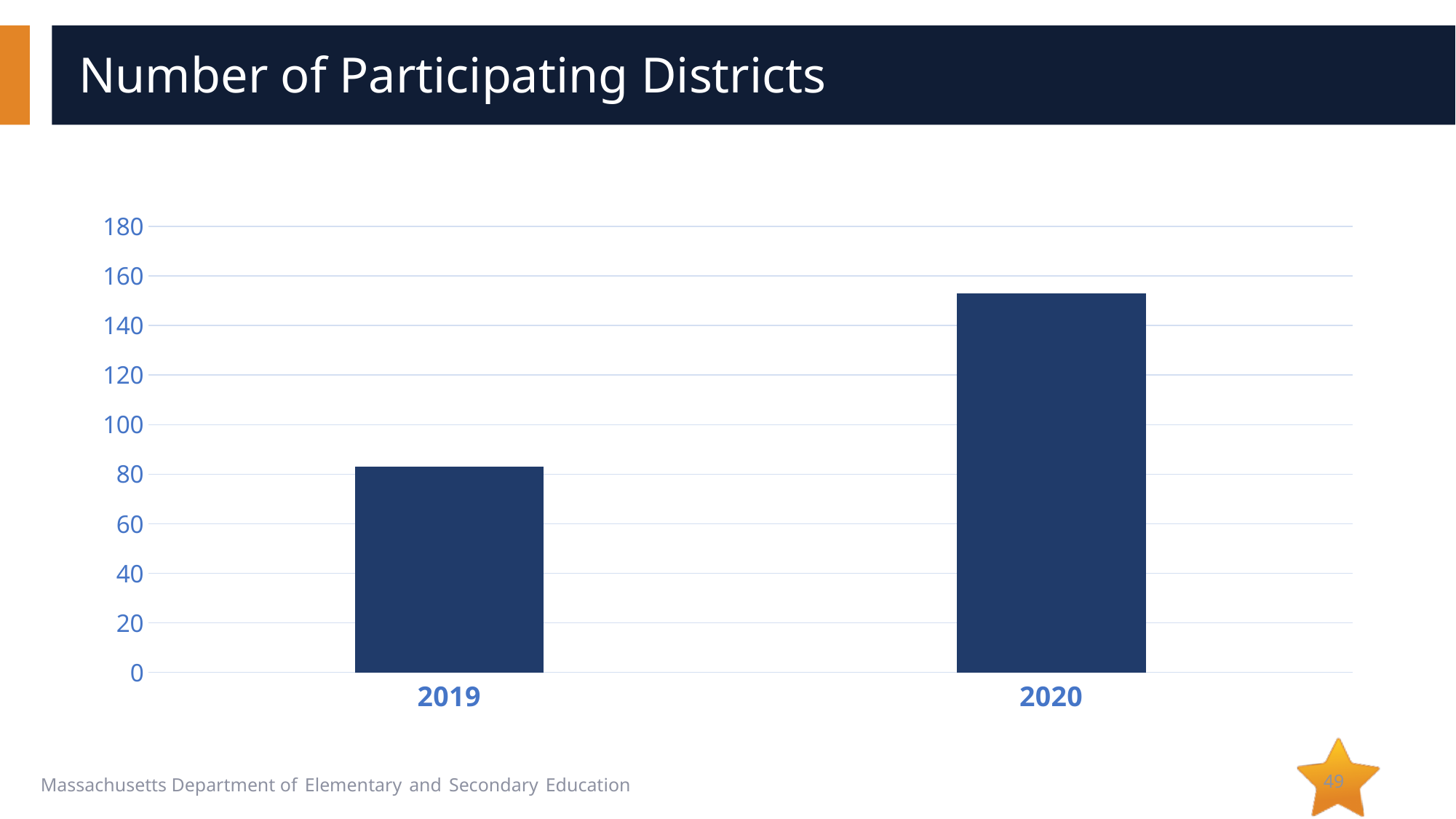
Is the value for 2019 greater or less than 100? less What kind of chart is shown on the slide? bar chart What is the title of the slide's chart? Number of Participating Districts Which year has the highest number of participating districts? 2020 Is the value for 2020 greater or less than 140? greater How many years are shown on the x axis of the chart? 2 What is the highest value shown on the chart's vertical axis? 180 Is the value for 2019 greater or less than 60? greater Which year has more participating districts, 2019 or 2020? 2020 Which year has the lowest number of participating districts? 2019 Does the number of participating districts rise or fall from 2019 to 2020? rise